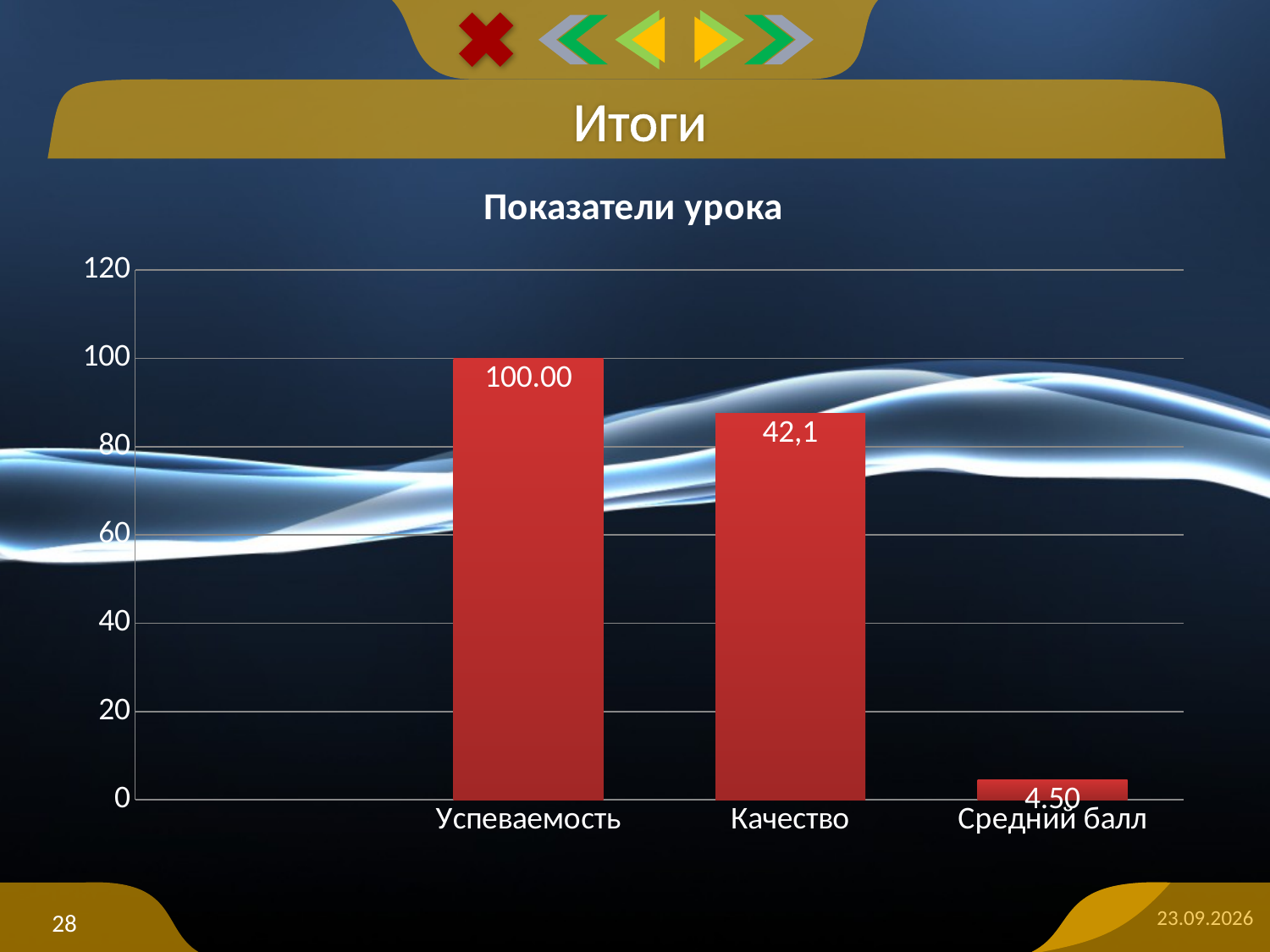
Which category has the lowest value? Средний балл How many categories are shown on the chart? 3 What is the title of the chart? Показатели урока Which category has the highest value? Успеваемость What is the value shown for Качество? 42,1 What kind of chart is shown on the slide? bar chart Which is larger, the value for Успеваемость or the value for Качество? Успеваемость Is the value for Успеваемость greater or less than 80? greater What is the value for Средний балл? 4.50 Is the value for Средний балл greater or less than 20? less What is the value for Успеваемость? 100.00 What is the difference between the values for Успеваемость and Средний балл? 95.50